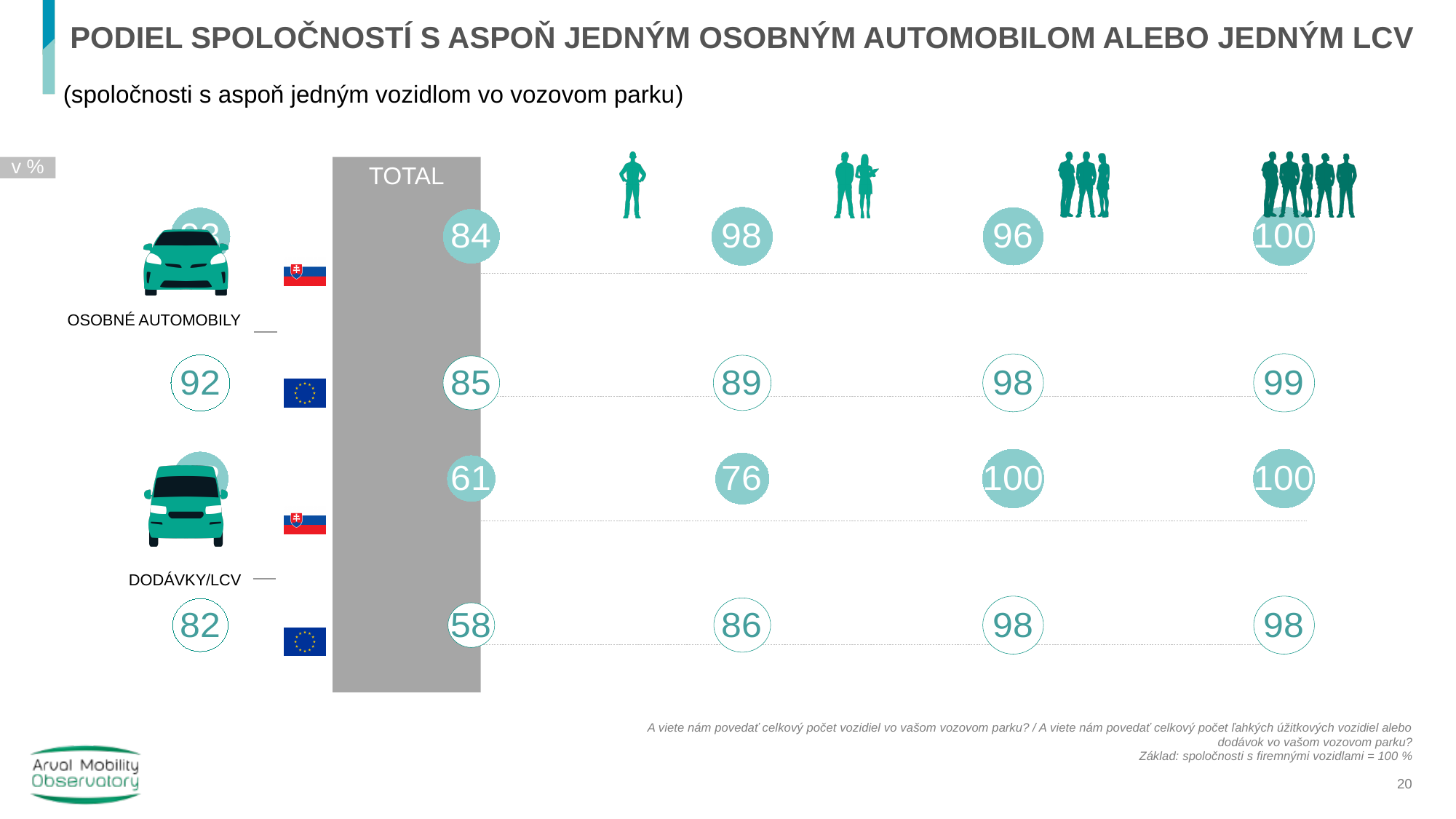
What is the difference between the TOTAL values for DODÁVKY/LCV in the Slovak-flag row and the EU-flag row? 3 In the DODÁVKY/LCV Slovak-flag row, which column has the lowest value? TOTAL In the OSOBNÉ AUTOMOBILY EU-flag row, do the values rise or fall from the single-person column to the largest-group column? rise Which is larger: the TOTAL value for OSOBNÉ AUTOMOBILY in the Slovak-flag row or in the EU-flag row? EU-flag row (85) What is the TOTAL value for DODÁVKY/LCV in the row with the EU flag? 58 What is the TOTAL value for OSOBNÉ AUTOMOBILY in the row with the EU flag? 85 What is the TOTAL value for DODÁVKY/LCV in the row with the Slovak flag? 61 What is the TOTAL value for OSOBNÉ AUTOMOBILY in the row with the Slovak flag? 84 What unit are the values on the slide expressed in, according to the label at the top left? %